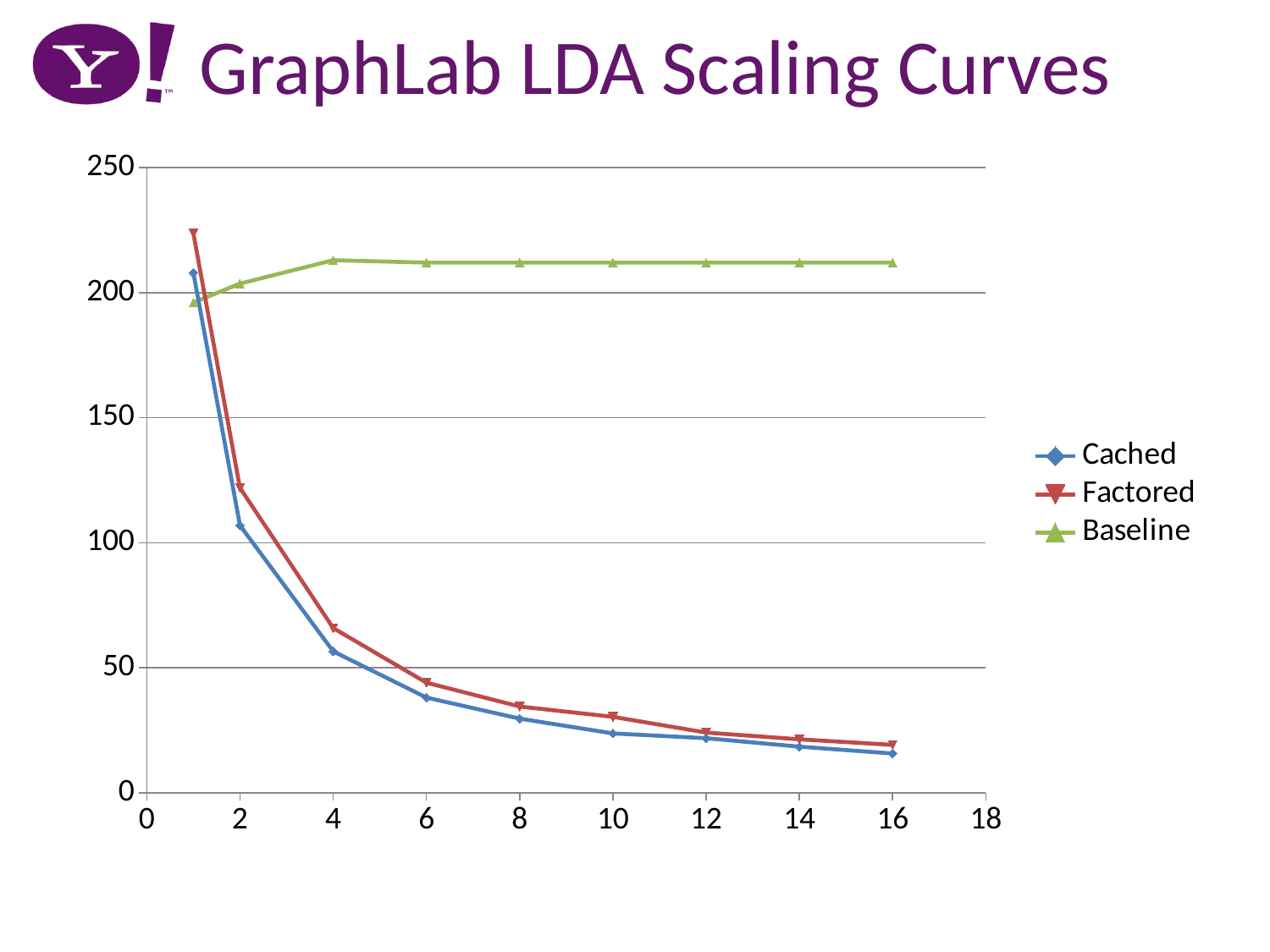
At x = 16, which is larger: the Baseline value or the Cached value? Baseline Is the value for Baseline at x = 16 greater or less than 200? greater Is the value for Factored at x = 1 greater or less than 200? greater What is the title of the slide? GraphLab LDA Scaling Curves Is the value for Cached at x = 2 greater or less than 150? less Which series has the highest value at x = 8? Baseline How many series does the legend list? 3 What kind of chart is shown on the slide? line chart Does the Cached series rise or fall as the x-axis value increases? fall How many data points are plotted for the Cached series? 9 At x = 1, which is larger: the Factored value or the Cached value? Factored